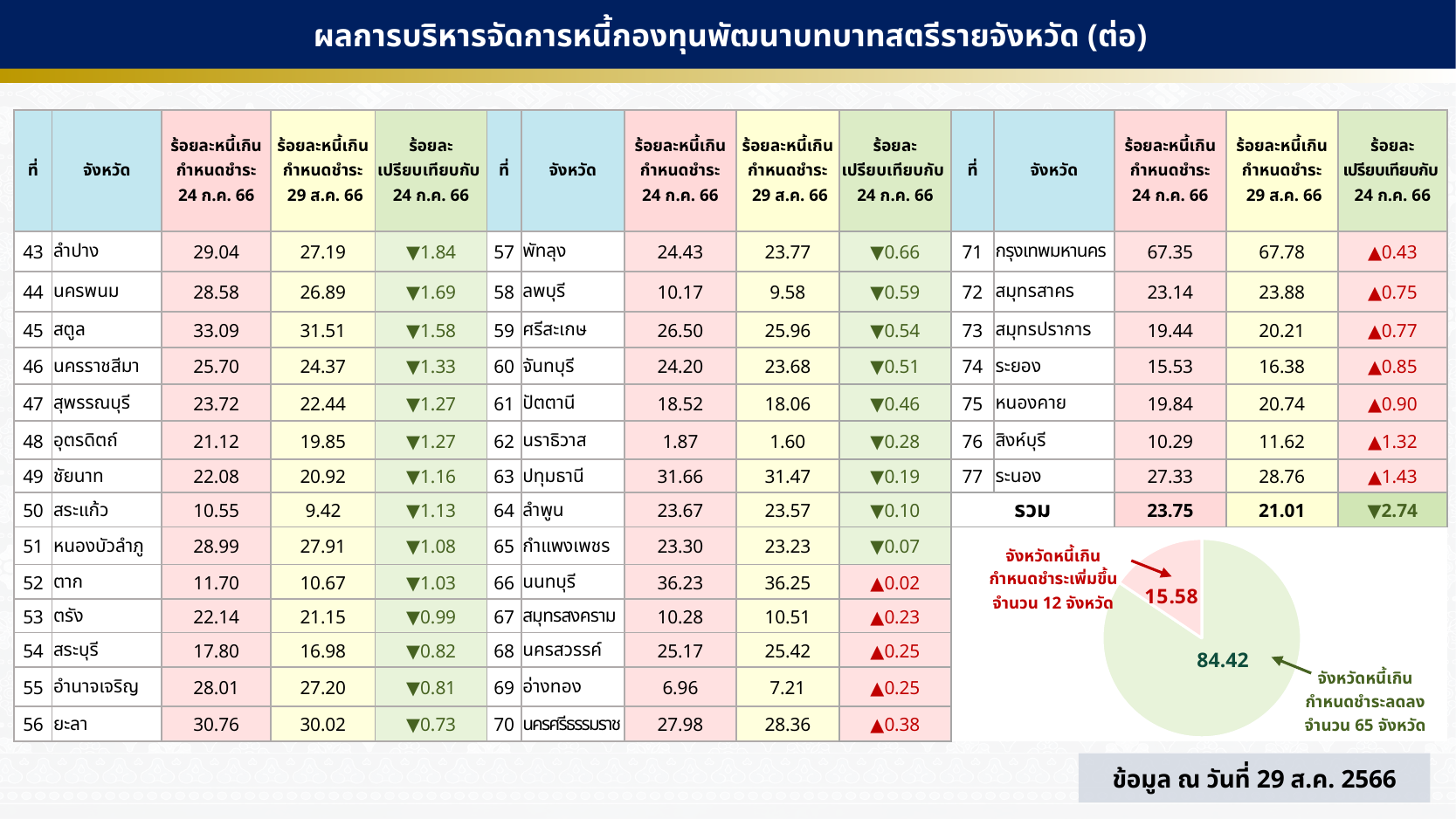
How many slices does the pie chart have? 2 What is the difference between the two slice values in the pie chart (84.42 and 15.58)? 68.84 In the pie chart, what value is shown for the slice labelled จังหวัดหนี้เกินกำหนดชำระเพิ่มขึ้น? 15.58 What kind of chart is shown at the bottom right of the slide? pie chart In the pie chart, what value is shown for the slice labelled จังหวัดหนี้เกินกำหนดชำระลดลง? 84.42 Which slice of the pie chart is the largest? จังหวัดหนี้เกินกำหนดชำระลดลง (84.42) According to the pie chart's label, how many provinces had a decrease in overdue debt? 65 จังหวัด Which slice of the pie chart is the smallest? จังหวัดหนี้เกินกำหนดชำระเพิ่มขึ้น (15.58) In the pie chart, is the slice for provinces with increased overdue debt larger or smaller than the slice for provinces with decreased overdue debt? smaller What do the two slice values in the pie chart add up to? 100.00 According to the pie chart's label, how many provinces had an increase in overdue debt? 12 จังหวัด